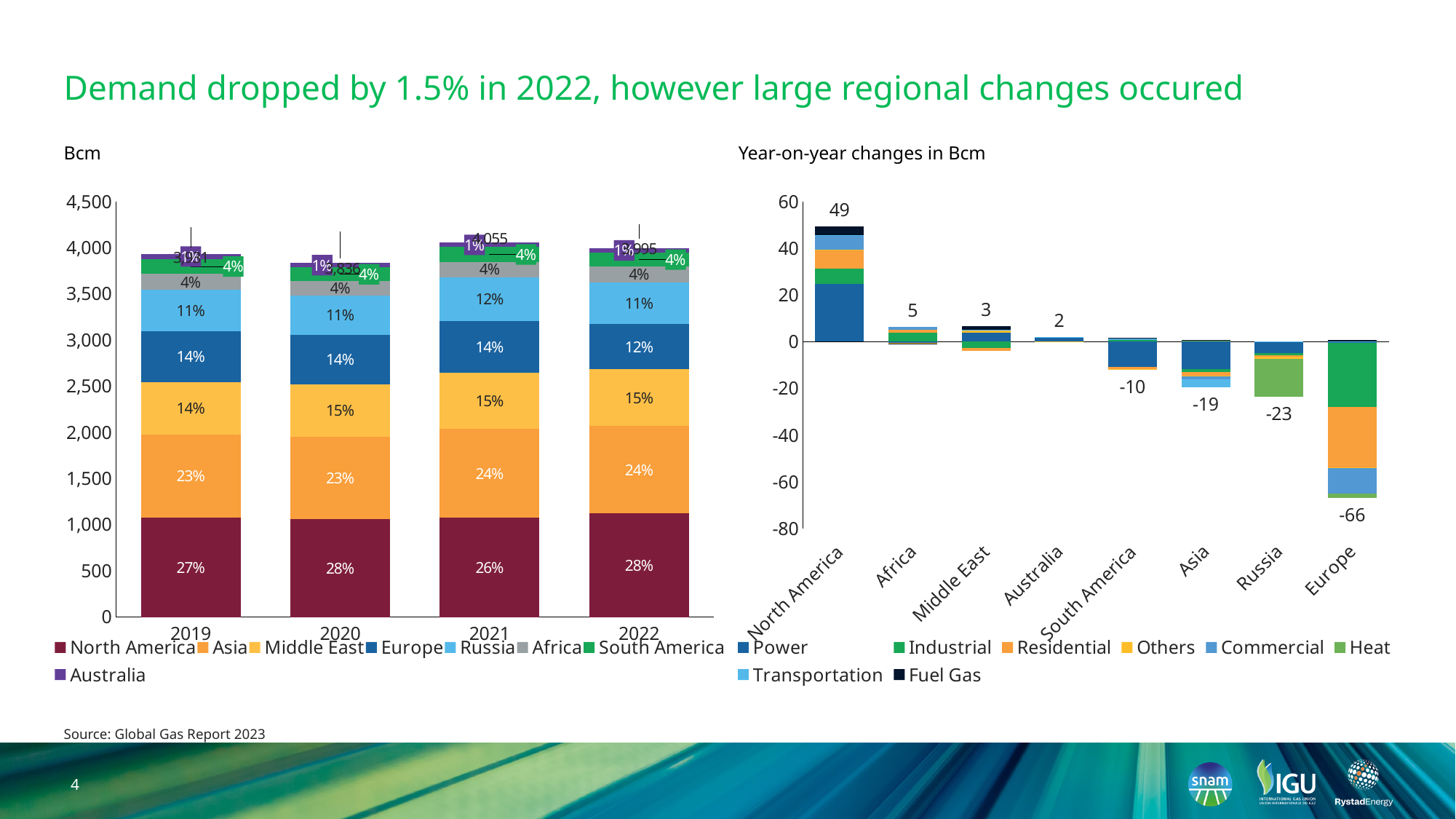
What kind of chart is the 'Bcm' chart on the left? Stacked bar chart In the 'Year-on-year changes in Bcm' chart, how many series does the legend list? 8 In the 'Year-on-year changes in Bcm' chart, what is the value for North America? 49 In the 'Year-on-year changes in Bcm' chart, is the value for Russia greater or less than -20? less In the 'Year-on-year changes in Bcm' chart, which region has the lowest value? Europe In the 'Year-on-year changes in Bcm' chart, how many regions are shown on the x axis? 8 In the 'Year-on-year changes in Bcm' chart, what is the difference between the values for Asia and Russia? 4 In the 'Bcm' chart on the left, what is the total labelled on the 2021 bar? 4,055 In the 'Year-on-year changes in Bcm' chart, what is the value for Europe? -66 In the 'Bcm' chart on the left, what share of demand does North America account for in 2022? 28% In the 'Year-on-year changes in Bcm' chart, which region has the highest value? North America In the 'Bcm' chart on the left, what share of demand does Europe account for in 2021? 14%